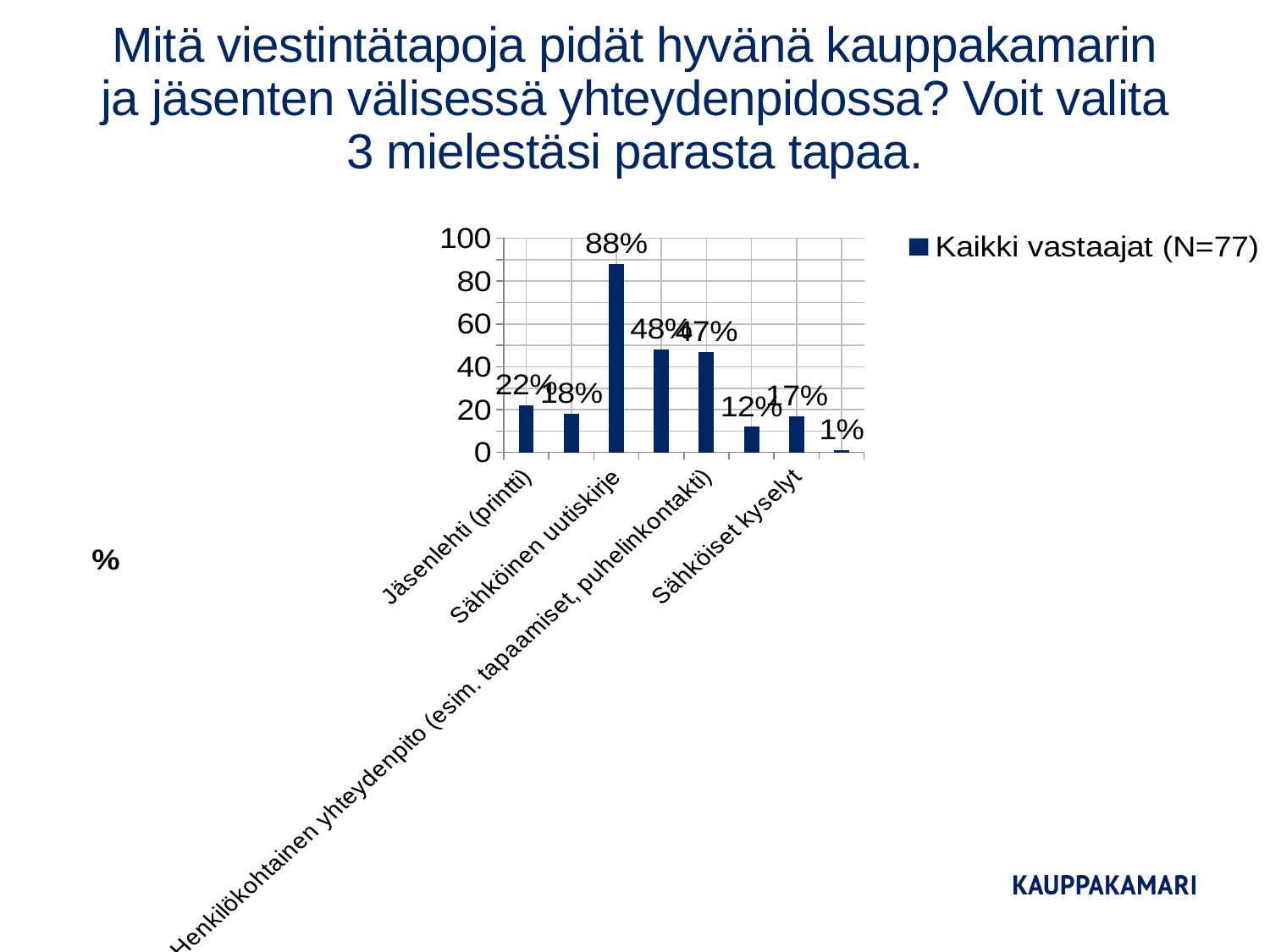
What is the value for Jäsenlehti (printti)? 22% What is the lowest value shown on the chart? 1% What is the value for Sähköinen uutiskirje? 88% What is the difference between the values for Sähköinen uutiskirje and Jäsenlehti (printti)? 66 percentage points How many series does the legend list? 1 Which category has the highest value? Sähköinen uutiskirje What kind of chart is shown on the slide? Bar chart How many bars are plotted on the chart? 8 What is the value for Henkilökohtainen yhteydenpito (esim. tapaamiset, puhelinkontakti)? 47% What is the value for Sähköiset kyselyt? 17% Which is larger, the value for Jäsenlehti (printti) or the value for Sähköiset kyselyt? Jäsenlehti (printti) Is the value for Sähköinen uutiskirje greater or less than 80? greater